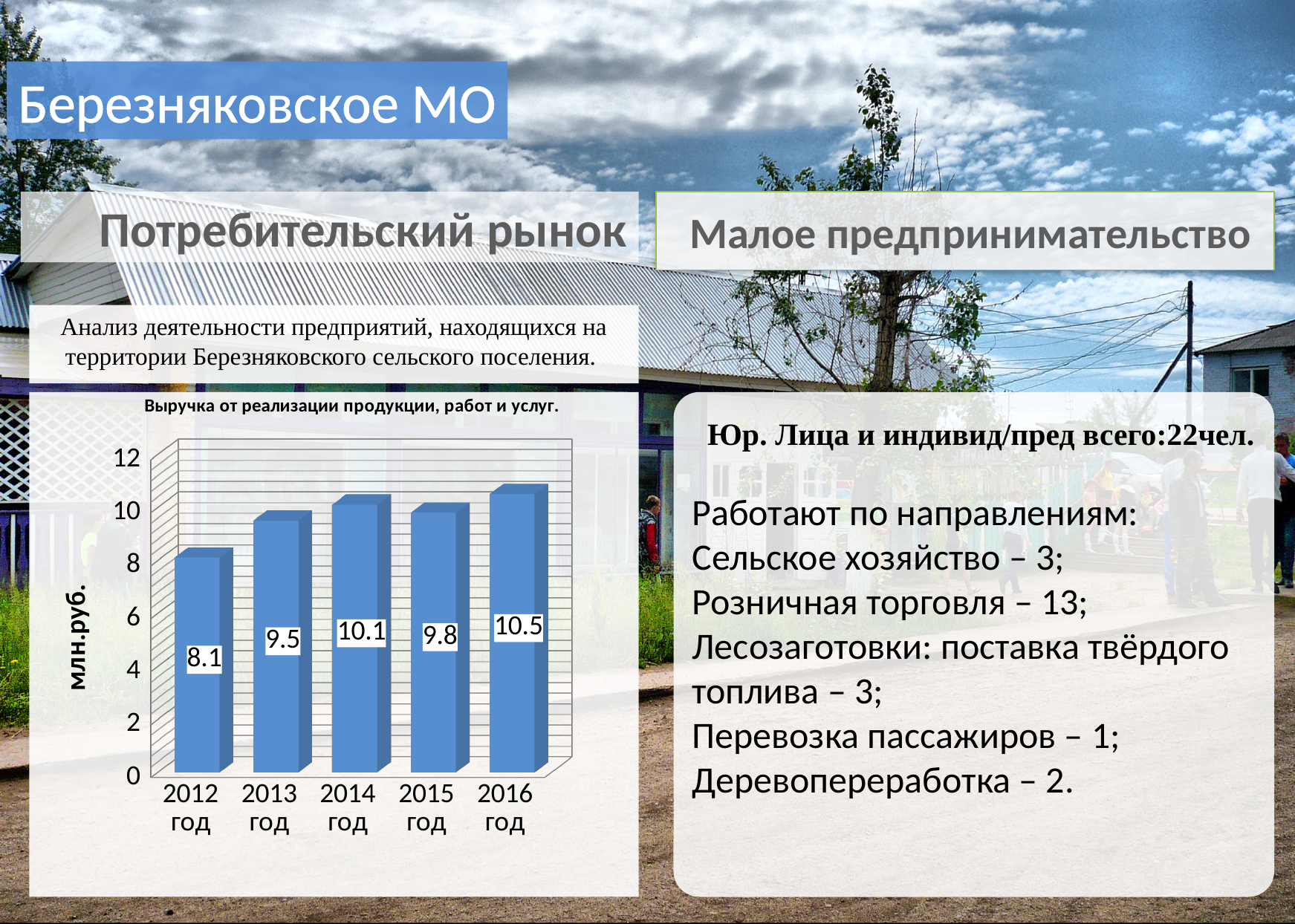
What is the value for 2015 год in the chart? 9.8 Which is larger, the value for 2013 год or the value for 2015 год? 2015 год What is the difference between the values for 2014 год and 2015 год? 0.3 Which year has the highest value in the chart? 2016 год Is the value for 2012 год greater or less than 10? less What is the label on the vertical axis of the chart? млн.руб. What is the value for 2012 год in the chart? 8.1 What kind of chart is shown on the slide? bar chart Which year has the lowest value in the chart? 2012 год What is the difference between the values for 2016 год and 2012 год? 2.4 How many years are shown on the x axis of the chart? 5 What is the value for 2014 год in the chart? 10.1